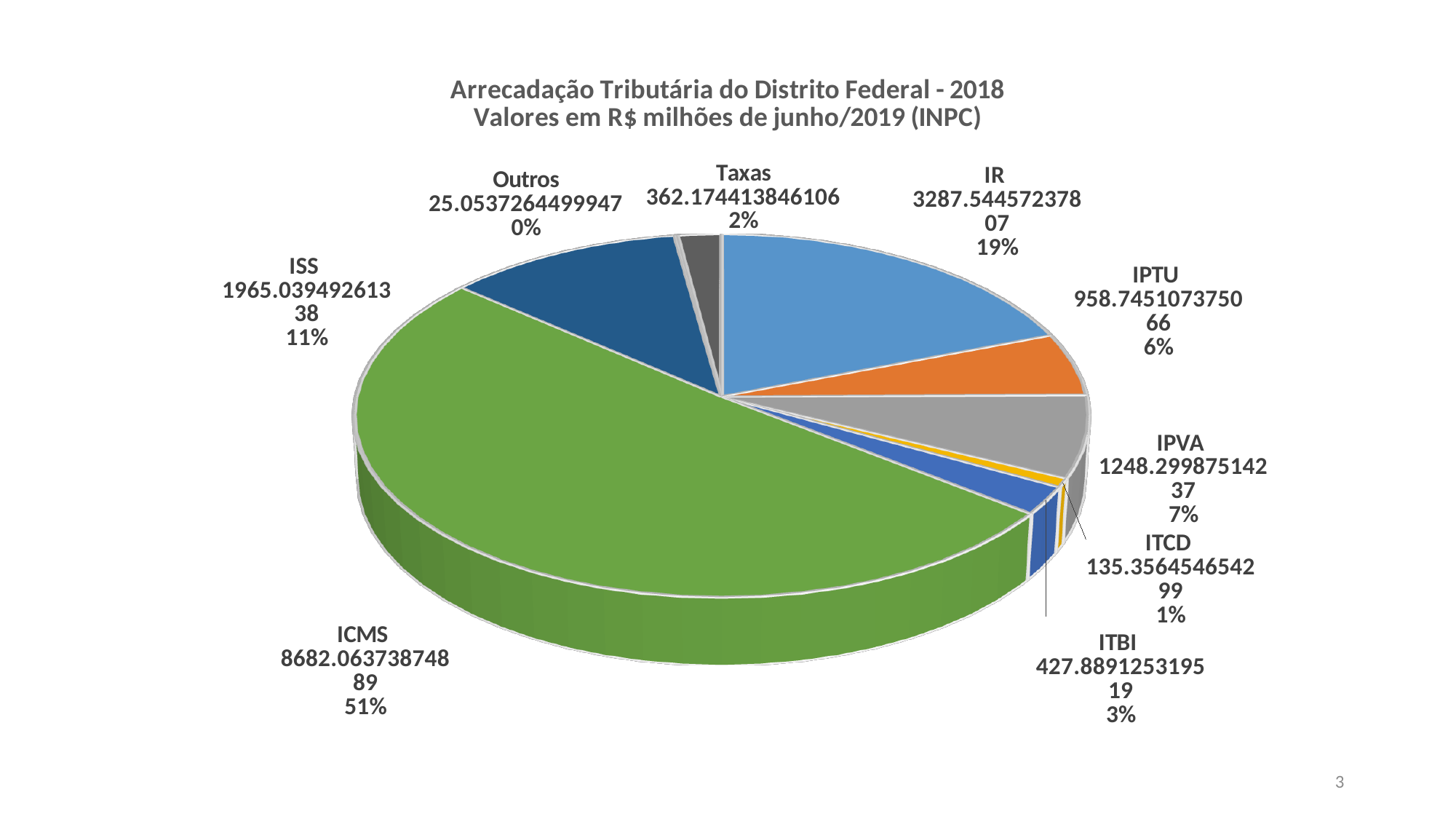
What kind of chart is shown on the slide? pie chart How many slices does the pie chart have? 9 What is the value shown for Taxas? 362.174413846106 By how many percentage points does the ICMS share exceed the IR share? 32 What is the value shown for Outros? 25.0537264499947 What share of the pie does IPTU represent? 6% What is the title of the chart? Arrecadação Tributária do Distrito Federal - 2018 Valores em R$ milhões de junho/2019 (INPC) Which category has the largest slice of the pie? ICMS Which slice is larger, ISS or IPVA? ISS What share of the pie does IR represent? 19% What share of the pie does ICMS represent? 51% Which category has the smallest slice of the pie? Outros